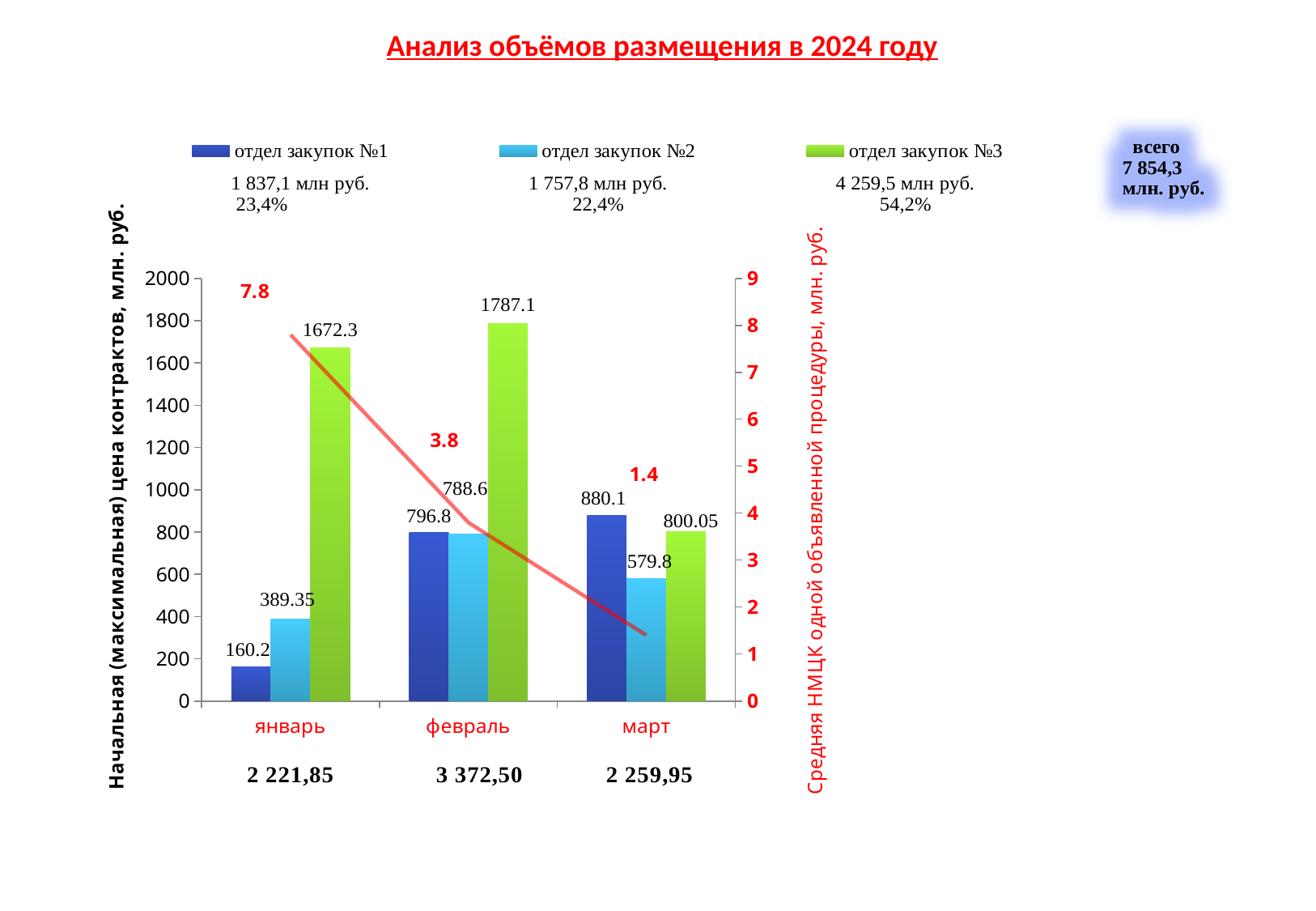
Does the red line rise or fall from январь to март? fall What is the value for отдел закупок №2 in февраль? 788.6 What is the title of the slide? Анализ объёмов размещения в 2024 году What is the value of the red line (Средняя НМЦК одной объявленной процедуры) for январь? 7.8 Which is larger in март: the value for отдел закупок №1 or отдел закупок №2? отдел закупок №1 How many months are shown on the x axis? 3 In which month is the value for отдел закупок №3 the highest? февраль What is the difference between the values for отдел закупок №3 and отдел закупок №2 in январь? 1282.95 How many series does the legend list? 3 What is the value for отдел закупок №3 in январь? 1672.3 In which month is the value for отдел закупок №1 the lowest? январь What is the value for отдел закупок №1 in март? 880.1